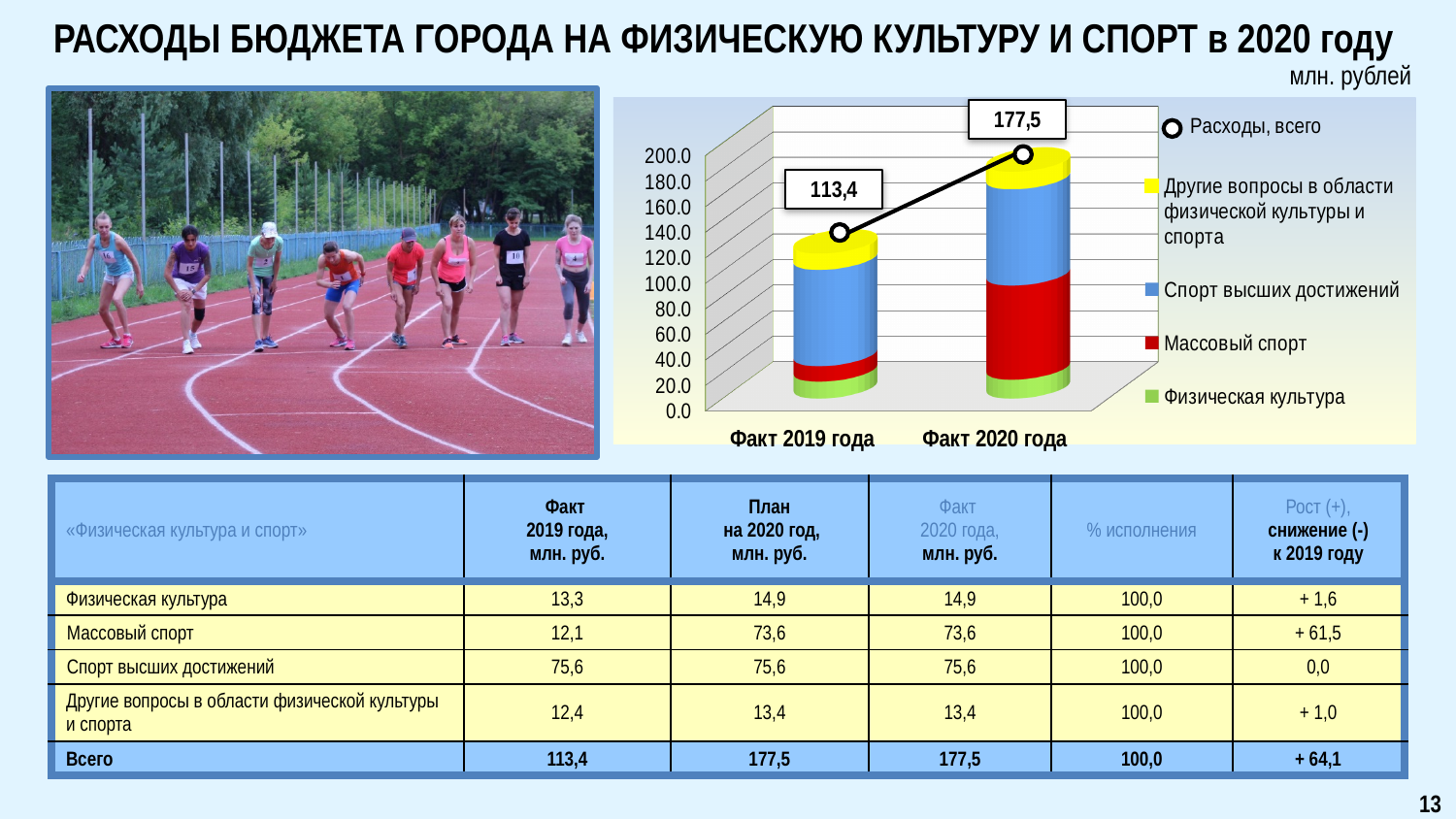
Does «Расходы, всего» rise or fall from Факт 2019 года to Факт 2020 года? Rise What colour represents «Массовый спорт» in the chart? Red Is the «Массовый спорт» segment for Факт 2020 года greater or less than 40? greater How many categories are shown on the x axis of the chart? 2 By how much does «Расходы, всего» for Факт 2020 года exceed the value for Факт 2019 года? 64,1 Which is larger for «Расходы, всего»: Факт 2019 года or Факт 2020 года? Факт 2020 года Which category has the highest total expenditure on the chart? Факт 2020 года How many series does the chart legend list? 5 What unit of measurement is indicated for the chart? млн. рублей What kind of chart is shown on the slide? Stacked bar chart with a line What is the value of «Расходы, всего» for Факт 2020 года? 177,5 What is the value of «Расходы, всего» for Факт 2019 года? 113,4